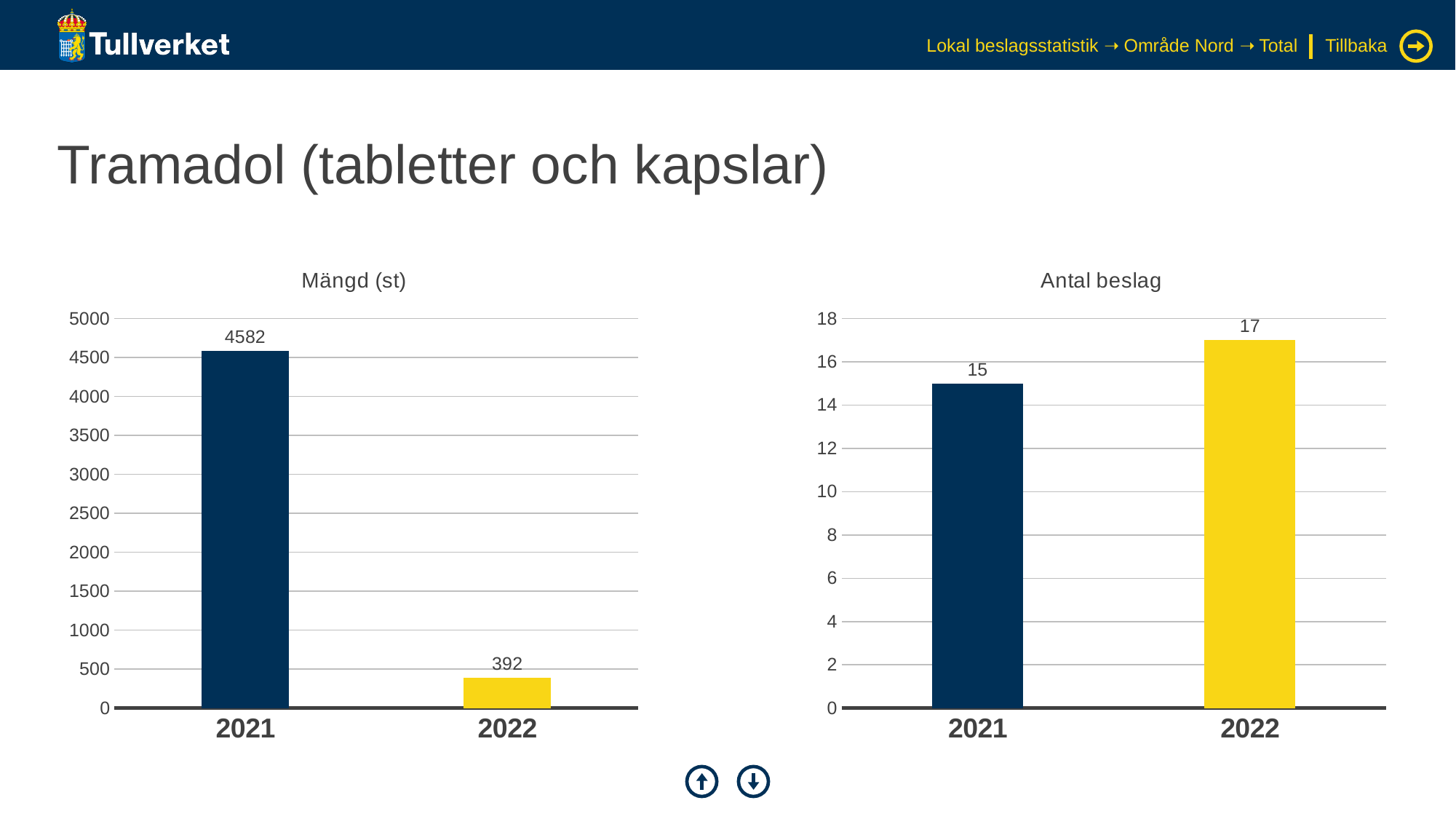
In the "Mängd (st)" chart, what is the value for 2021? 4582 In the "Antal beslag" chart, what is the value for 2021? 15 In the "Mängd (st)" chart, what is the value for 2022? 392 What kind of chart is the "Mängd (st)" chart? bar chart In the "Antal beslag" chart, which year has the larger value, 2021 or 2022? 2022 How many years are shown on the x axis of the "Antal beslag" chart? 2 In the "Mängd (st)" chart, is the value for 2022 greater or less than 500? less In the "Antal beslag" chart, which year has the lowest value? 2021 In the "Mängd (st)" chart, which year has the highest value? 2021 In the "Mängd (st)" chart, what is the difference between the 2021 and 2022 values? 4190 In the "Antal beslag" chart, what is the difference between the 2022 and 2021 values? 2 In the "Antal beslag" chart, what is the value for 2022? 17